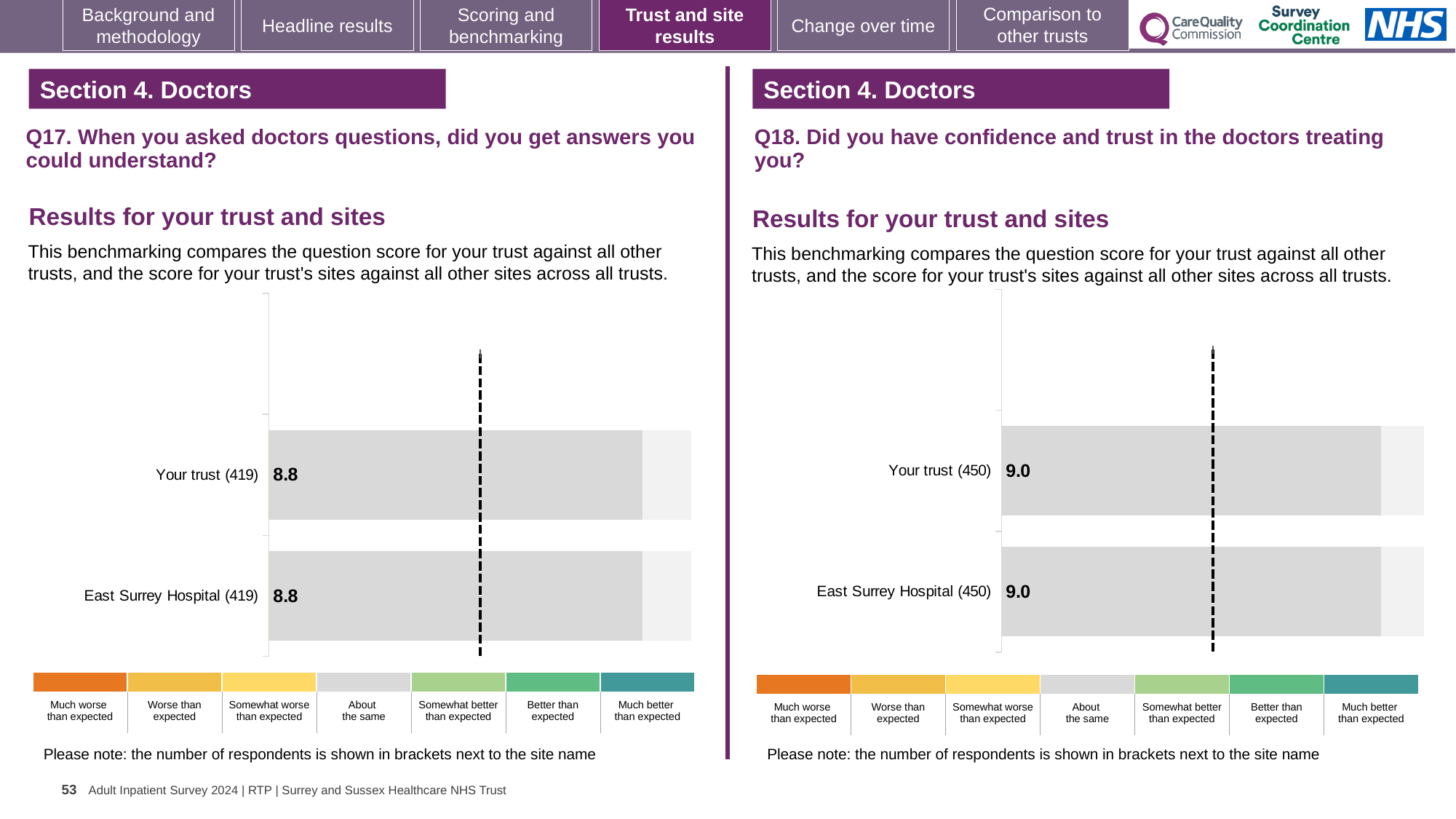
On the Q18 chart (right), how many respondents are shown in brackets next to East Surrey Hospital? 450 On the Q18 chart (right), what is the score for Your trust? 9.0 On the Q17 chart (left), what is the score for Your trust? 8.8 How many bars are plotted on the Q18 chart (right)? 2 On the Q17 chart (left), what is the score for East Surrey Hospital? 8.8 On the Q17 chart (left), what is the difference between the Your trust score and the East Surrey Hospital score? 0.0 On the Q18 chart (right), what is the difference between the Your trust score and the East Surrey Hospital score? 0.0 How many categories does the colour key below the Q17 chart (left) list? 7 On the Q17 chart (left), how many respondents are shown in brackets next to Your trust? 419 On the Q18 chart (right), which benchmark category does the grey colour of the bars correspond to in the key? About the same On the Q18 chart (right), what is the score for East Surrey Hospital? 9.0 What kind of chart is used on the Q17 chart (left)? Bar chart